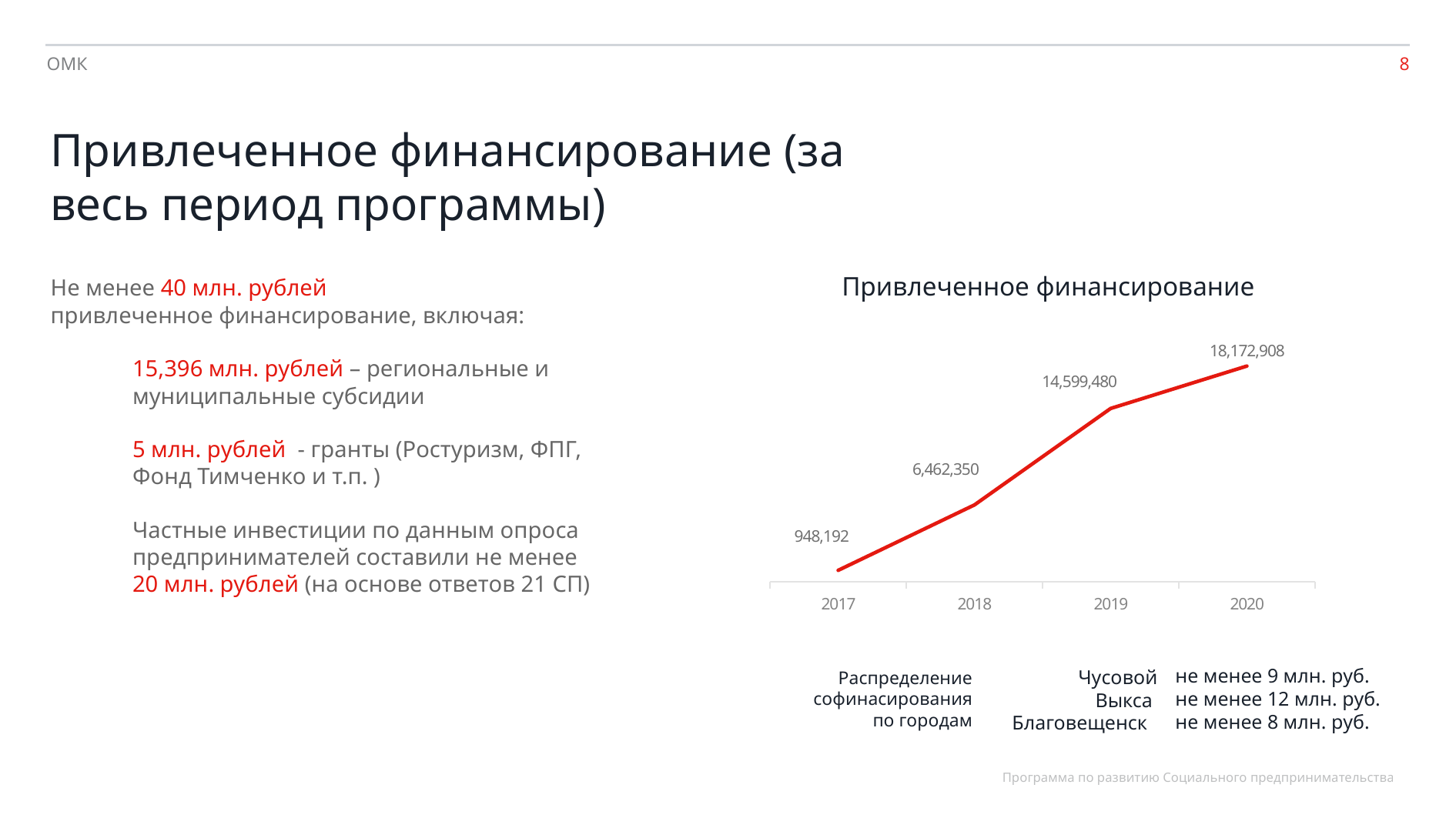
What is the difference between the 2020 and 2019 values in the chart "Привлеченное финансирование"? 3,573,428 Which year has the highest value in the chart "Привлеченное финансирование"? 2020 In the chart "Привлеченное финансирование", which is larger: the value for 2018 or the value for 2019? 2019 What kind of chart is "Привлеченное финансирование"? Line chart Which year has the lowest value in the chart "Привлеченное финансирование"? 2017 How many years are plotted in the chart "Привлеченное финансирование"? 4 What is the value for 2020 in the chart "Привлеченное финансирование"? 18,172,908 What is the value for 2019 in the chart "Привлеченное финансирование"? 14,599,480 What is the value for 2018 in the chart "Привлеченное финансирование"? 6,462,350 What is the value for 2017 in the chart "Привлеченное финансирование"? 948,192 Do the values in the chart "Привлеченное финансирование" rise or fall from 2017 to 2020? Rise What is the difference between the 2019 and 2018 values in the chart "Привлеченное финансирование"? 8,137,130